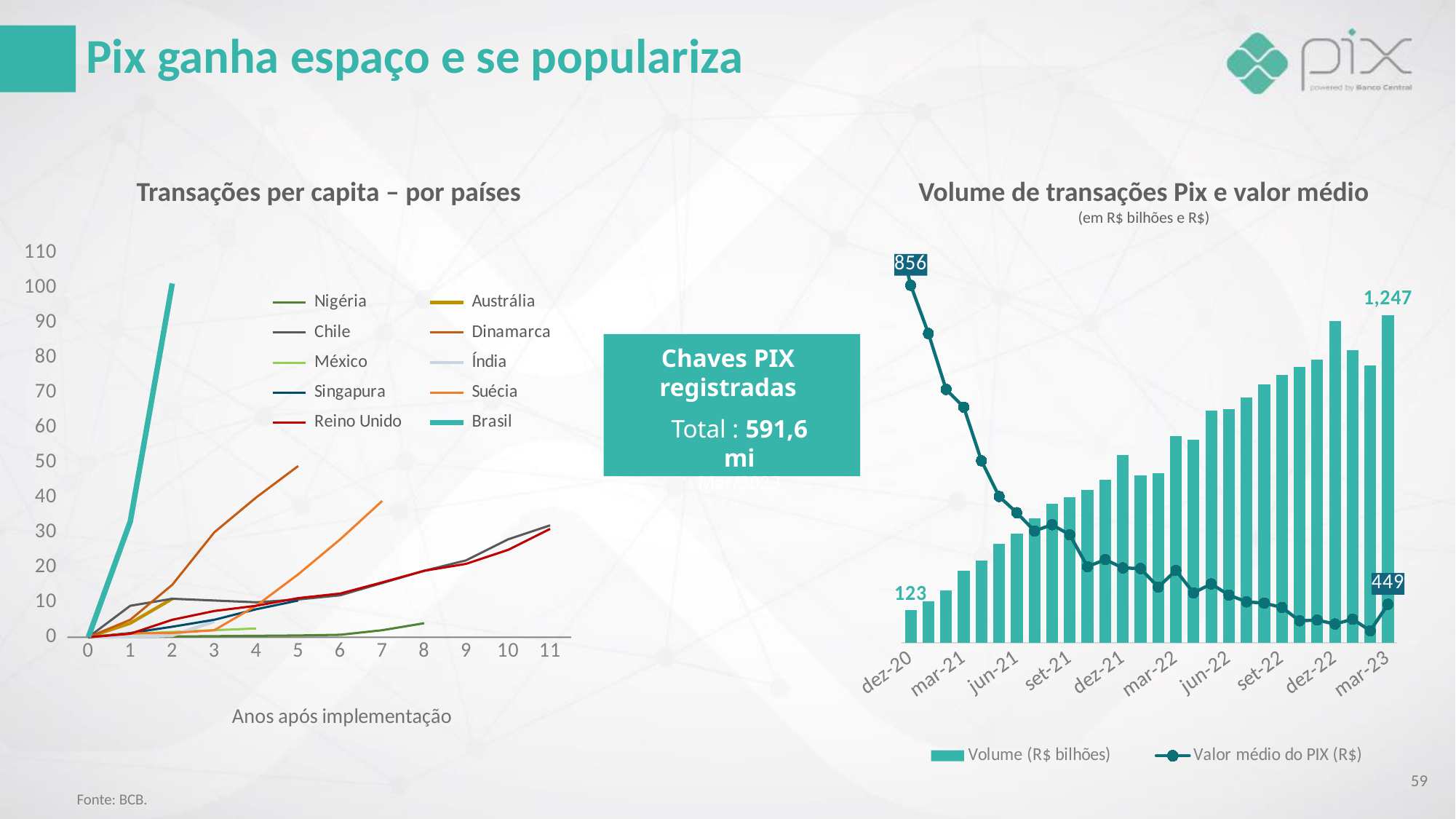
In the chart 'Volume de transações Pix e valor médio', what is the Valor médio do PIX (R$) for dez-20? 856 In the chart 'Volume de transações Pix e valor médio', how many series does the legend list? 2 In the chart 'Volume de transações Pix e valor médio', what is the Volume (R$ bilhões) value for dez-20? 123 In the chart 'Volume de transações Pix e valor médio', what is the Volume (R$ bilhões) value for mar-23? 1,247 What kind of chart is 'Transações per capita – por países'? line chart In the chart 'Transações per capita – por países', which country reaches the highest value? Brasil In the chart 'Volume de transações Pix e valor médio', by how much did the Valor médio do PIX (R$) fall from dez-20 to mar-23? 407 In the chart 'Volume de transações Pix e valor médio', what is the Valor médio do PIX (R$) for mar-23? 449 In the chart 'Volume de transações Pix e valor médio', by how much did the Volume (R$ bilhões) increase from dez-20 to mar-23? 1,124 In the chart 'Volume de transações Pix e valor médio', does the Valor médio do PIX line rise or fall from dez-20 to mar-23? fall In the chart 'Transações per capita – por países', how many countries does the legend list? 10 In the chart 'Transações per capita – por países', is the value for Brasil at year 2 greater or less than 90? greater